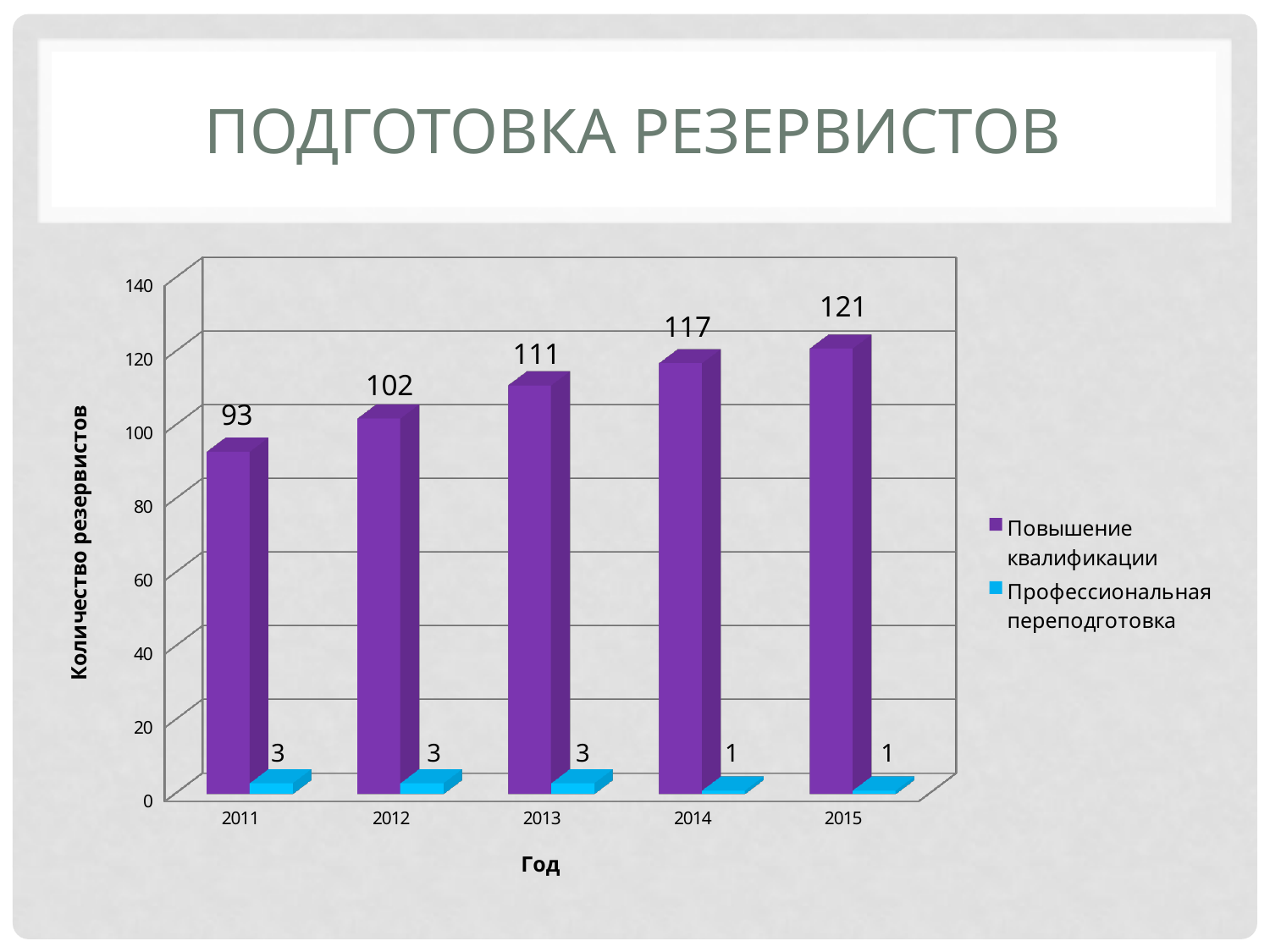
Is the value for Повышение квалификации in 2011 greater or less than 100? less Which is larger: Повышение квалификации in 2012 or in 2014? 2014 What is the value for Повышение квалификации in 2015? 121 Do the values for Повышение квалификации rise or fall from 2011 to 2015? rise What is the difference between the Повышение квалификации values for 2015 and 2011? 28 How many series does the legend list? 2 How many years are shown on the x axis? 5 Which year has the highest value for Повышение квалификации? 2015 Which year has the lowest value for Повышение квалификации? 2011 What is the value for Профессиональная переподготовка in 2012? 3 What is the value for Повышение квалификации in 2013? 111 What kind of chart is shown on the slide? bar chart